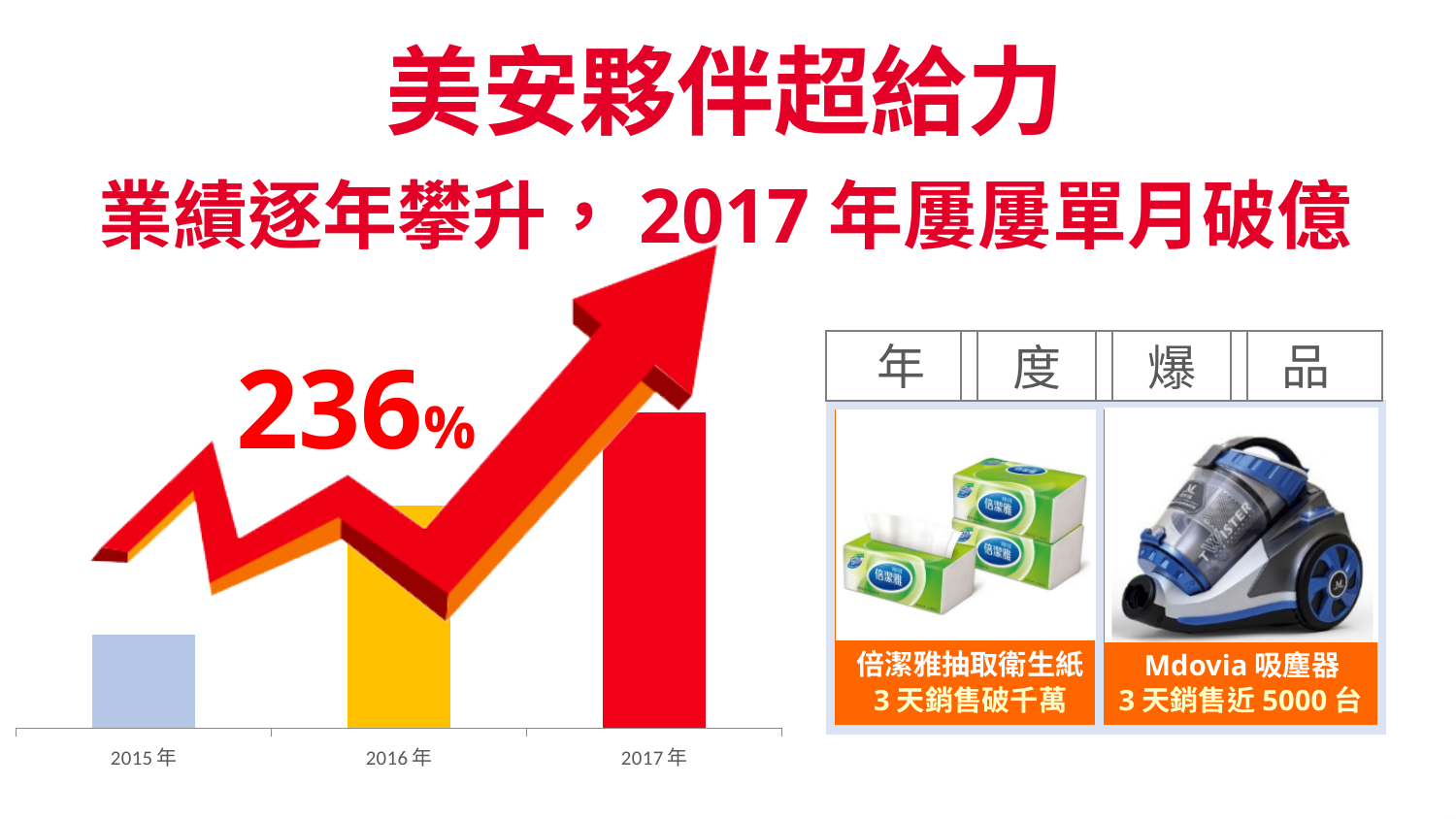
What colour is the bar for 2017年? red Do the bar values rise or fall from 2015年 to 2017年? rise Which year has the tallest bar in the chart? 2017年 What kind of chart is shown on the left of the slide? bar chart What percentage figure is printed above the bars in the chart? 236% Which bar is taller, 2016年 or 2017年? 2017年 Which year has the shortest bar in the chart? 2015年 Which bar is taller, 2015年 or 2016年? 2016年 How many categories (years) are shown on the x axis of the bar chart? 3